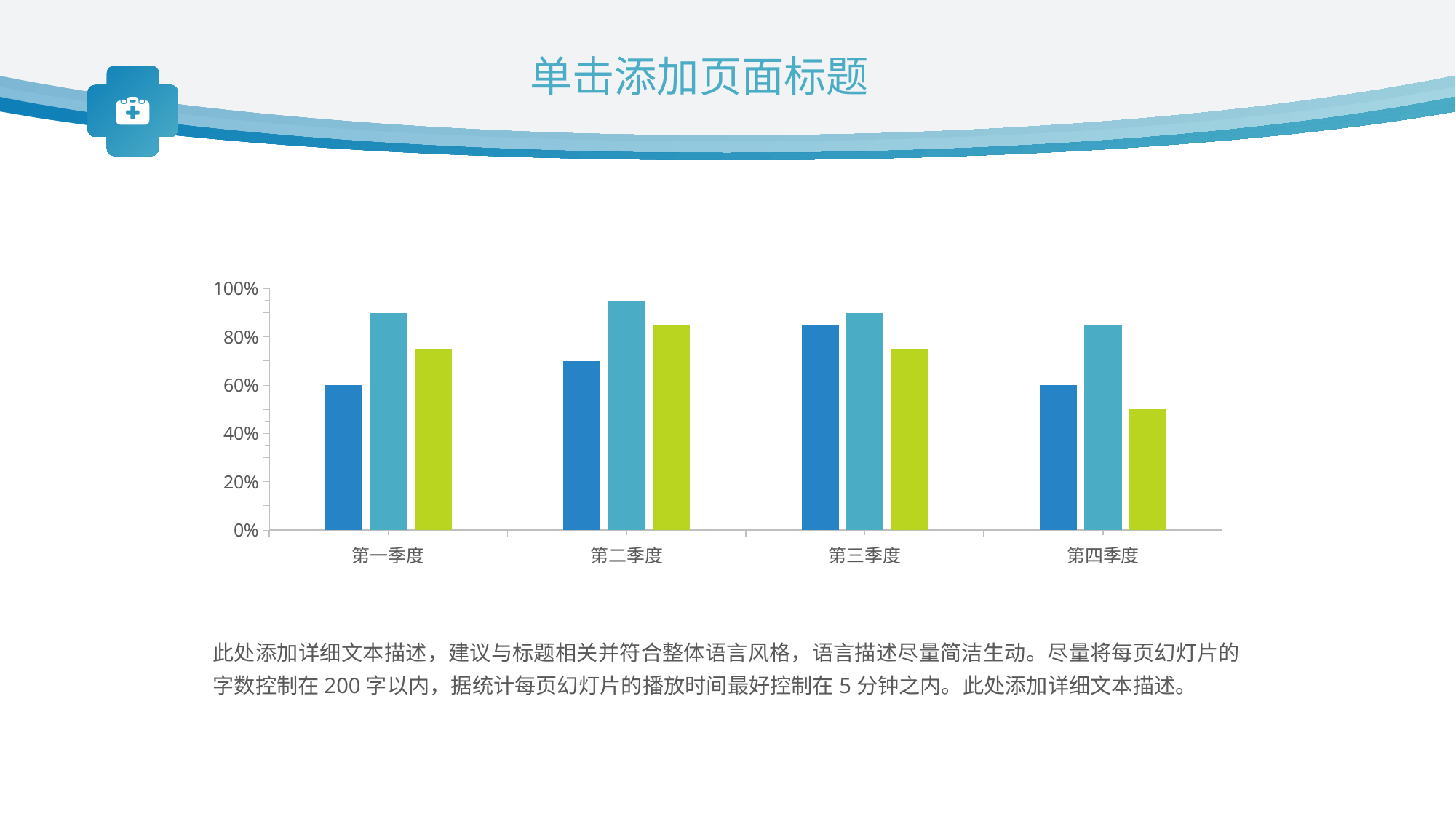
What kind of chart is shown on the slide? bar chart What is the value of the dark blue bar for 第一季度? 60% Is the value of the dark blue bar for 第三季度 greater or less than 80%? greater How many bars are plotted for each quarter in the chart? 3 Is the value of the green bar for 第一季度 greater or less than 80%? less Which quarter has the tallest bar in the chart? 第二季度 For 第一季度, which bar is taller, the dark blue bar or the teal bar? the teal bar Is the value of the green bar for 第四季度 greater or less than 60%? less Which quarter has the shortest bar in the chart? 第四季度 What is the value of the dark blue bar for 第四季度? 60% How many categories are shown on the x axis of the chart? 4